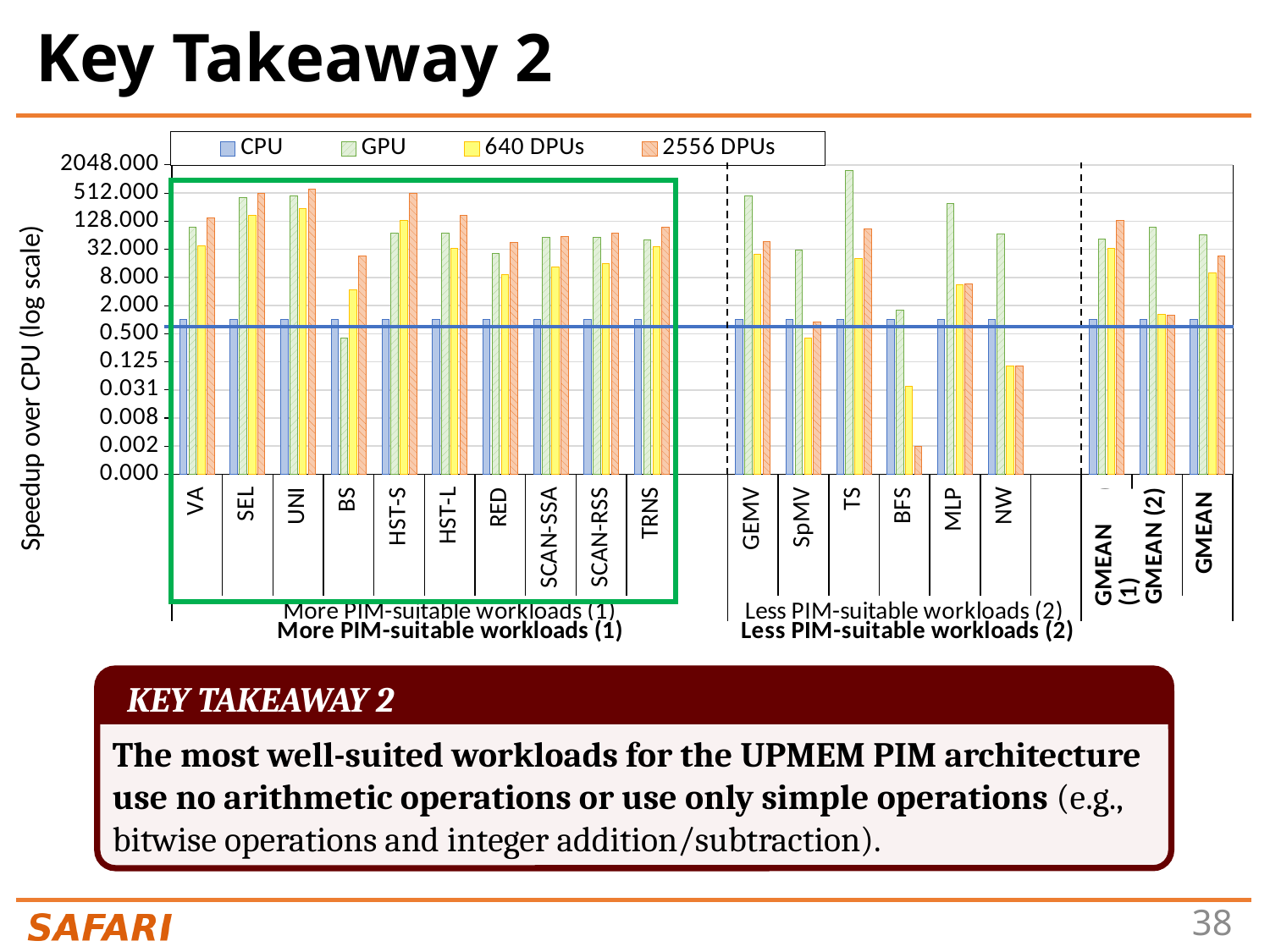
Is the 2556 DPUs value for BFS greater or less than 0.125? less How many series does the chart's legend list? 4 Is the 640 DPUs value for VA greater or less than 8? greater Is the 2556 DPUs value for NW greater or less than 0.5? less What kind of chart is shown on the slide? bar chart For the BS workload, which is larger: the GPU value or the 2556 DPUs value? 2556 DPUs What is the label of the y axis of the chart? Speedup over CPU (log scale) Which workload has the highest GPU bar in the chart? TS Which series has the tallest bar for the TS workload? GPU For the GEMV workload, which is larger: the GPU value or the 640 DPUs value? GPU